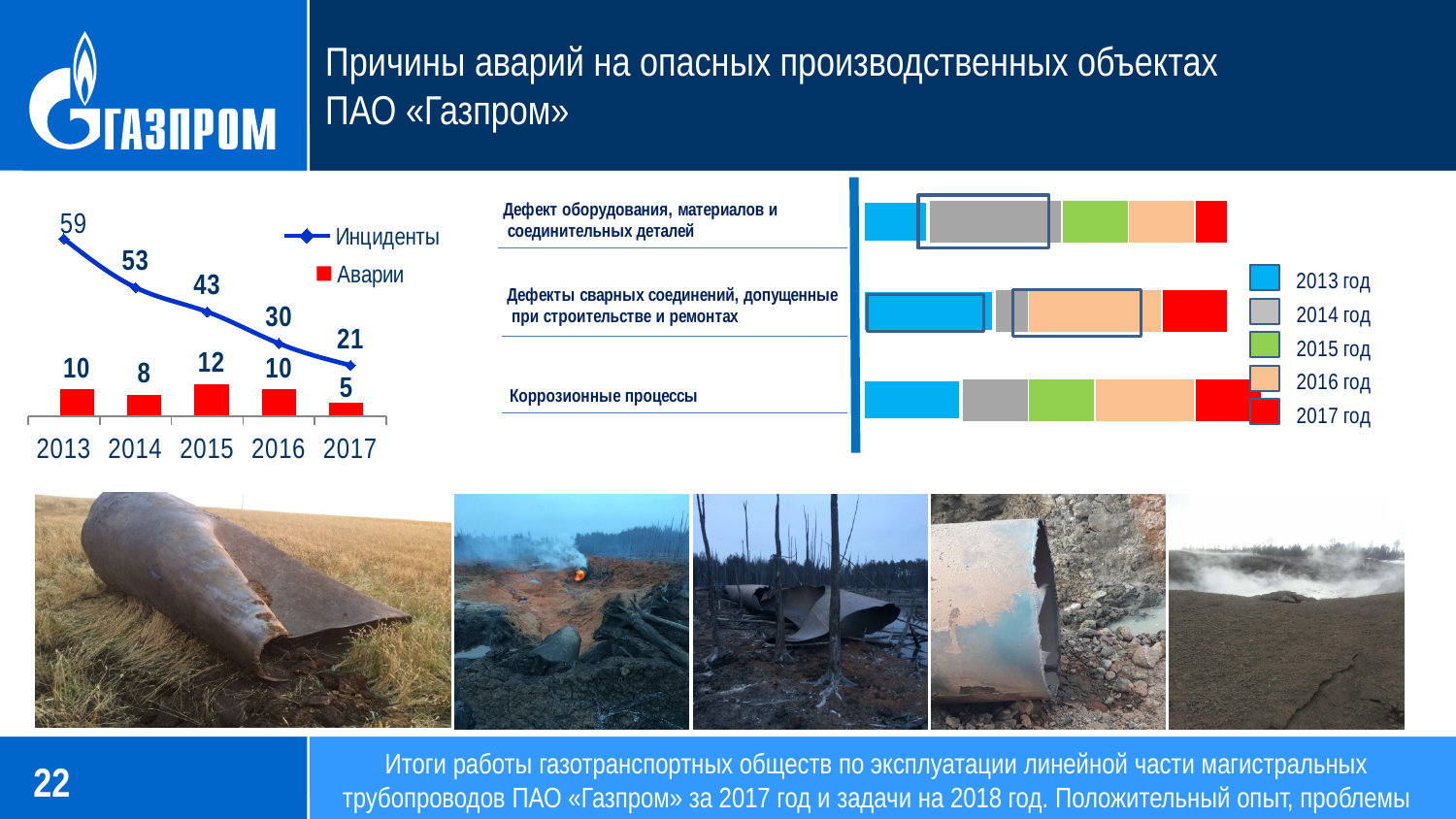
In the left chart, what is the value of Инциденты for 2013? 59 In the left chart, how many series does the legend list? 2 In the left chart, what is the difference between Инциденты in 2013 and in 2017? 38 In the left chart, which year has the lowest value of Аварии? 2017 In the left chart, how many years are shown on the x axis? 5 In the left chart, which year has the highest value of Инциденты? 2013 In the left chart, what is the value of Инциденты for 2017? 21 In the left chart, which is larger: Аварии in 2014 or Аварии in 2016? 2016 In the left chart, what is the value of Аварии for 2015? 12 In the right chart, how many years does the legend list? 5 In the left chart, does the Инциденты line rise or fall from 2013 to 2017? fall What kind of chart is the right chart? stacked bar chart